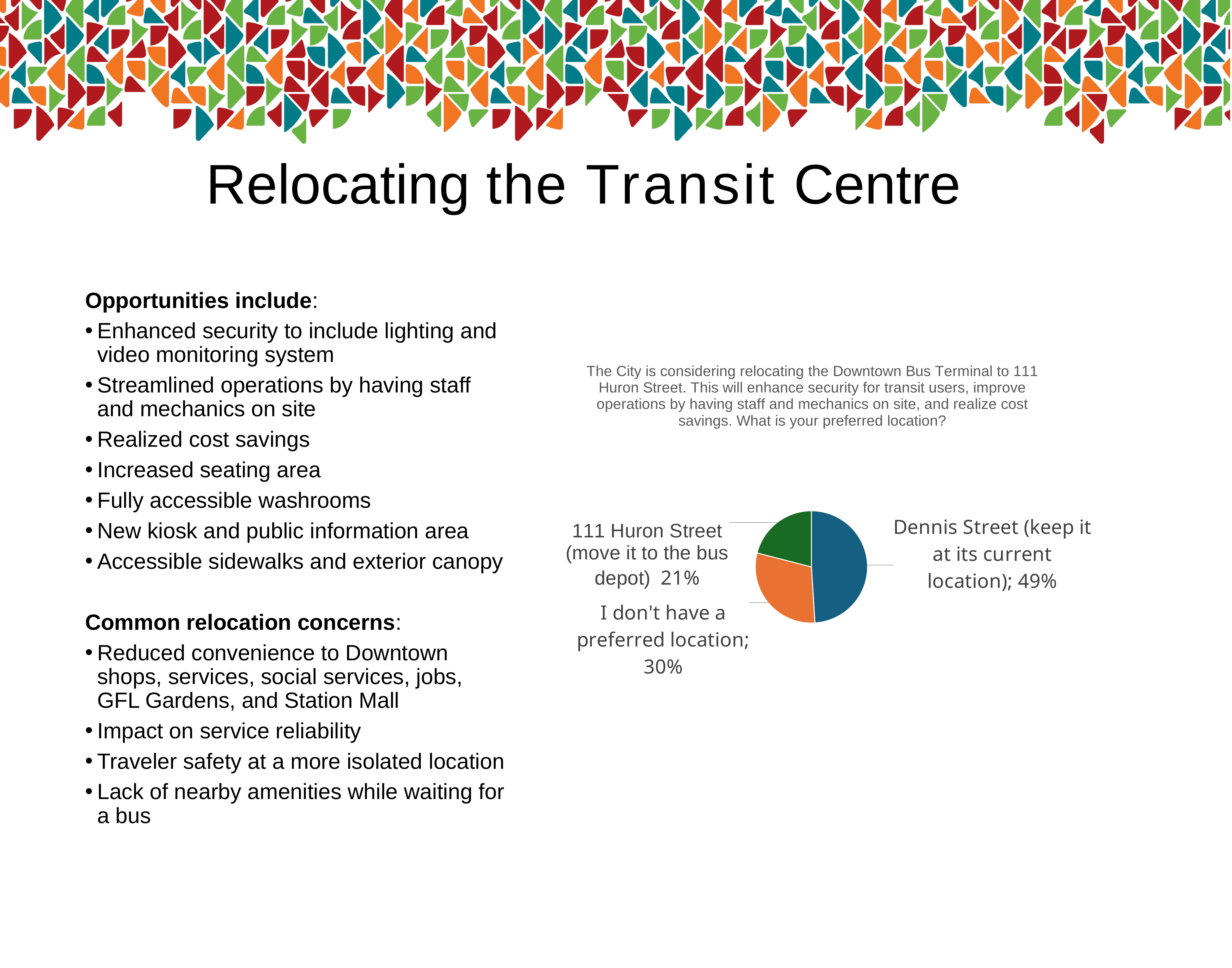
How many slices does the pie chart have? 3 What is the difference in percentage points between 'I don't have a preferred location' and 111 Huron Street? 9 What kind of chart is shown on the slide? Pie chart Which option has the largest share of the pie? Dennis Street (keep it at its current location) What colour is the slice for 111 Huron Street (move it to the bus depot)? Dark green What share of respondents preferred 111 Huron Street (move it to the bus depot)? 21% What colour is the slice for Dennis Street (keep it at its current location)? Blue Which option has the smallest share of the pie? 111 Huron Street (move it to the bus depot) What share of respondents preferred Dennis Street (keep it at its current location)? 49% What share of respondents said they don't have a preferred location? 30% What is the difference in percentage points between Dennis Street and 111 Huron Street? 28 Which is larger: the share for 'I don't have a preferred location' or the share for 111 Huron Street? I don't have a preferred location